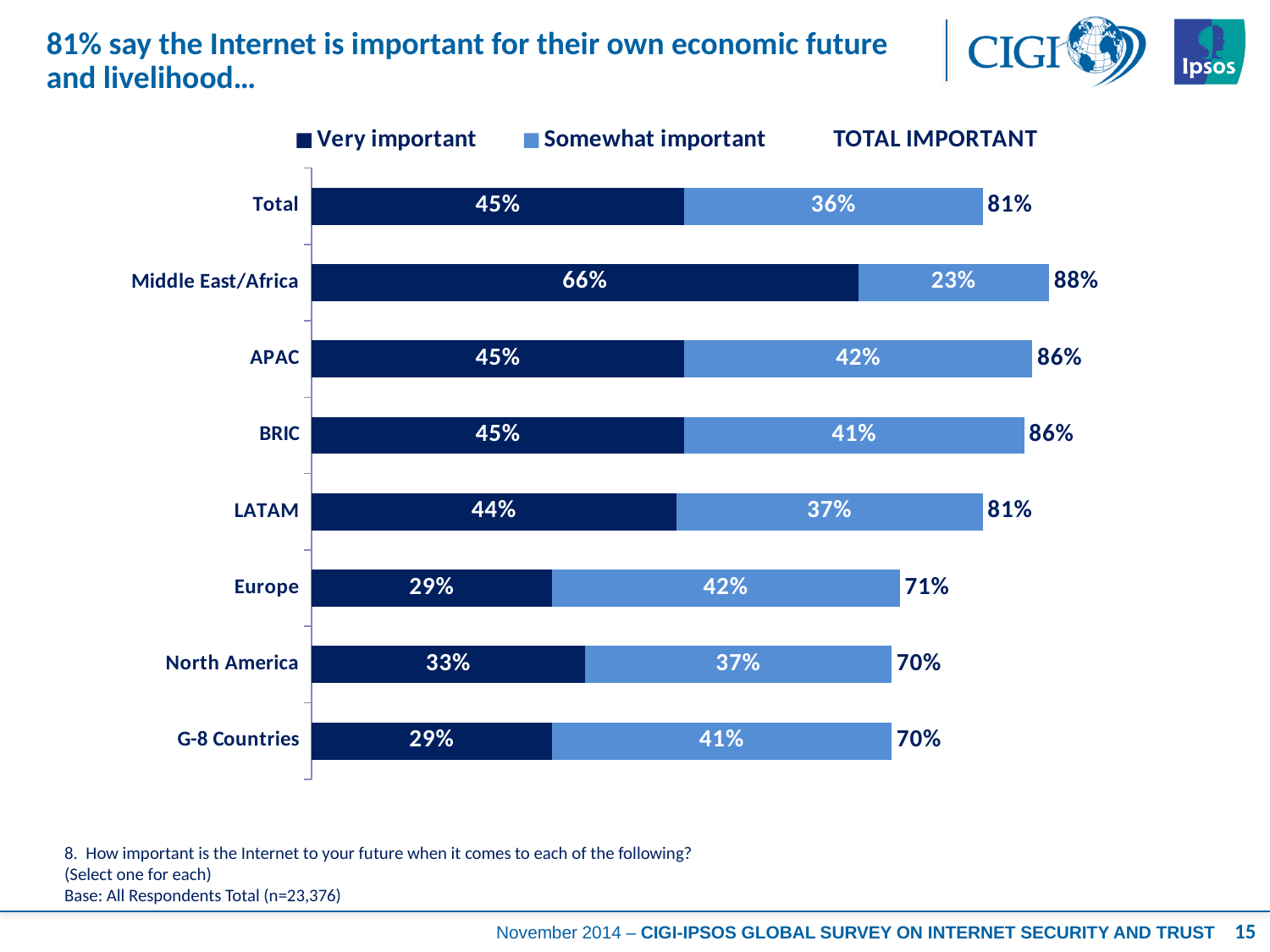
Which is larger, the 'Somewhat important' value for APAC or for BRIC? APAC What is the difference between the 'Very important' values for Middle East/Africa and Europe? 37 percentage points Which series is shown in dark blue in the legend? Very important How many categories (rows) are shown in the chart? 8 What kind of chart is shown on the slide? Stacked bar chart What is the 'Somewhat important' value for Europe? 42% What is the TOTAL IMPORTANT value for North America? 70% What is the total of the stacked bar for LATAM? 81% What percentage of respondents in Middle East/Africa say the Internet is very important for their economic future? 66% Which region has the lowest 'Somewhat important' percentage? Middle East/Africa Which region has the highest 'Very important' percentage? Middle East/Africa How many series does the legend list? 3